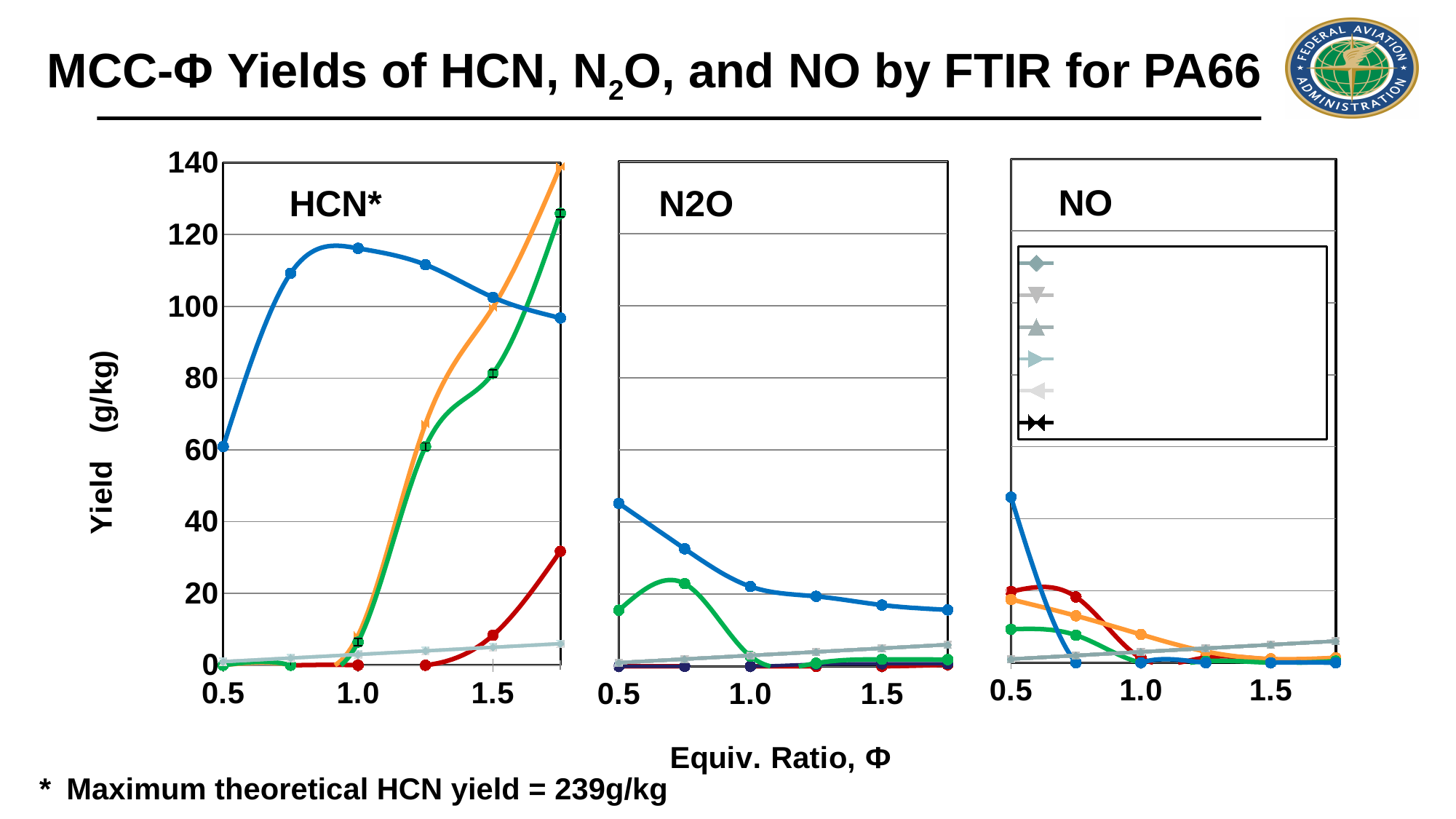
How many separate chart panels are shown on the slide? 3 According to the footnote, what is the maximum theoretical HCN yield? 239g/kg In the HCN* chart, is the value of the blue line at an equivalence ratio of 0.5 greater or less than 40? greater In the N2O chart, does the blue line rise or fall as the equivalence ratio increases from 0.5 to 1.75? fall In the HCN* chart, at an equivalence ratio of 1.75, which is larger: the orange line or the red line? the orange line In the NO chart, is the value of the blue line at an equivalence ratio of 0.5 greater or less than 40? greater What kind of chart is used for the HCN*, N2O, and NO panels on this slide? line chart What is the highest value labeled on the y-axis of the charts? 140 In the N2O chart, is the value of the blue line at an equivalence ratio of 0.5 greater or less than 60? less What is the y-axis title shared by the three charts? Yield (g/kg)